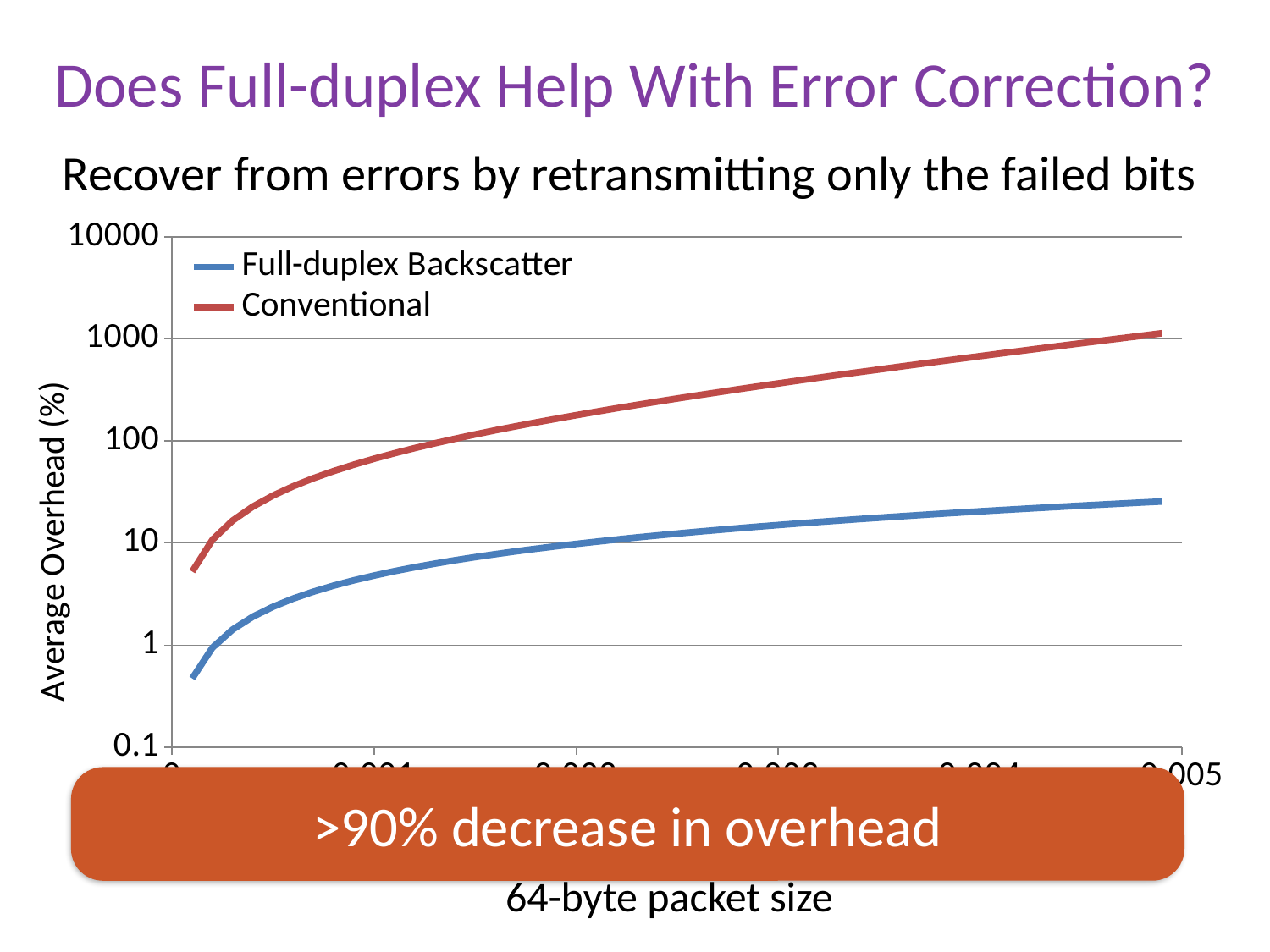
What is the label of the y axis? Average Overhead (%) What kind of chart is shown on the slide? line chart Which series has the lower average overhead across the whole x range? Full-duplex Backscatter Does the Conventional line rise or fall as the x value increases? rise Is the Full-duplex Backscatter value at x = 0.001 greater or less than 10? less Which series has the higher average overhead at x = 0.003, Full-duplex Backscatter or Conventional? Conventional Is the Conventional value at x = 0.001 greater or less than 100? less How many series does the legend list? 2 Which two series are listed in the legend? Full-duplex Backscatter and Conventional Is the Conventional value at x = 0.003 greater or less than 100? greater Does the Full-duplex Backscatter line rise or fall along the x axis? rise